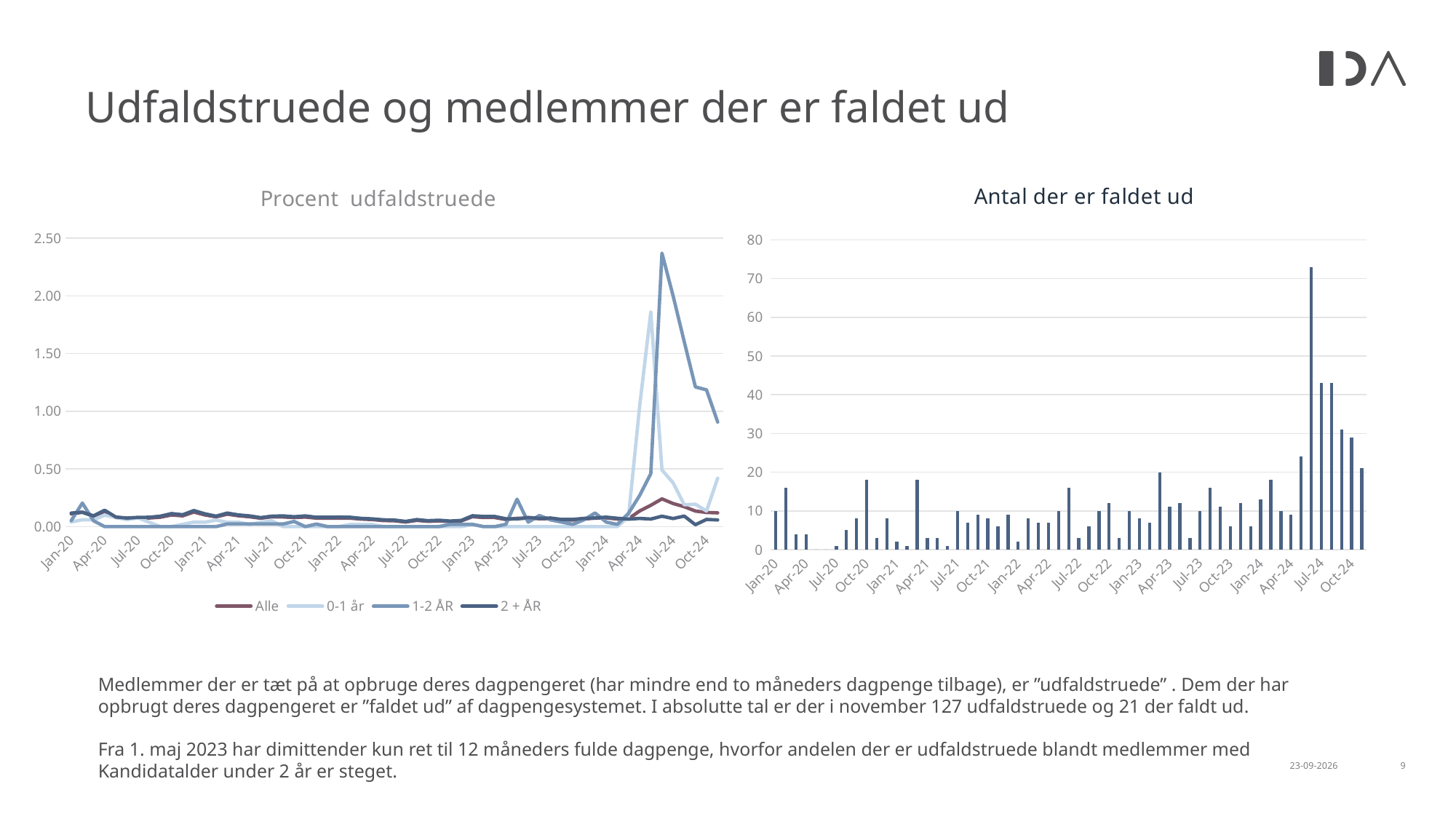
What kind of chart is the 'Procent udfaldstruede' chart on the left? line chart In the 'Procent udfaldstruede' chart, is the peak value of the Alle series greater or less than 0.50? less In the 'Procent udfaldstruede' chart, how many series does the legend list? 4 In the 'Procent udfaldstruede' chart, which series is drawn in dark red? Alle What kind of chart is the 'Antal der er faldet ud' chart on the right? bar chart In the 'Antal der er faldet ud' chart, is the first bar (Jan-20) greater or less than 20? less What is the title of the chart on the right side of the slide? Antal der er faldet ud In the 'Antal der er faldet ud' chart, are the bars generally higher in 2024 than in 2020? yes, higher in 2024 In the 'Procent udfaldstruede' chart, which series reaches the highest peak value? 1-2 ÅR In the 'Procent udfaldstruede' chart, is the peak value of the 0-1 år series greater or less than 1.50? greater